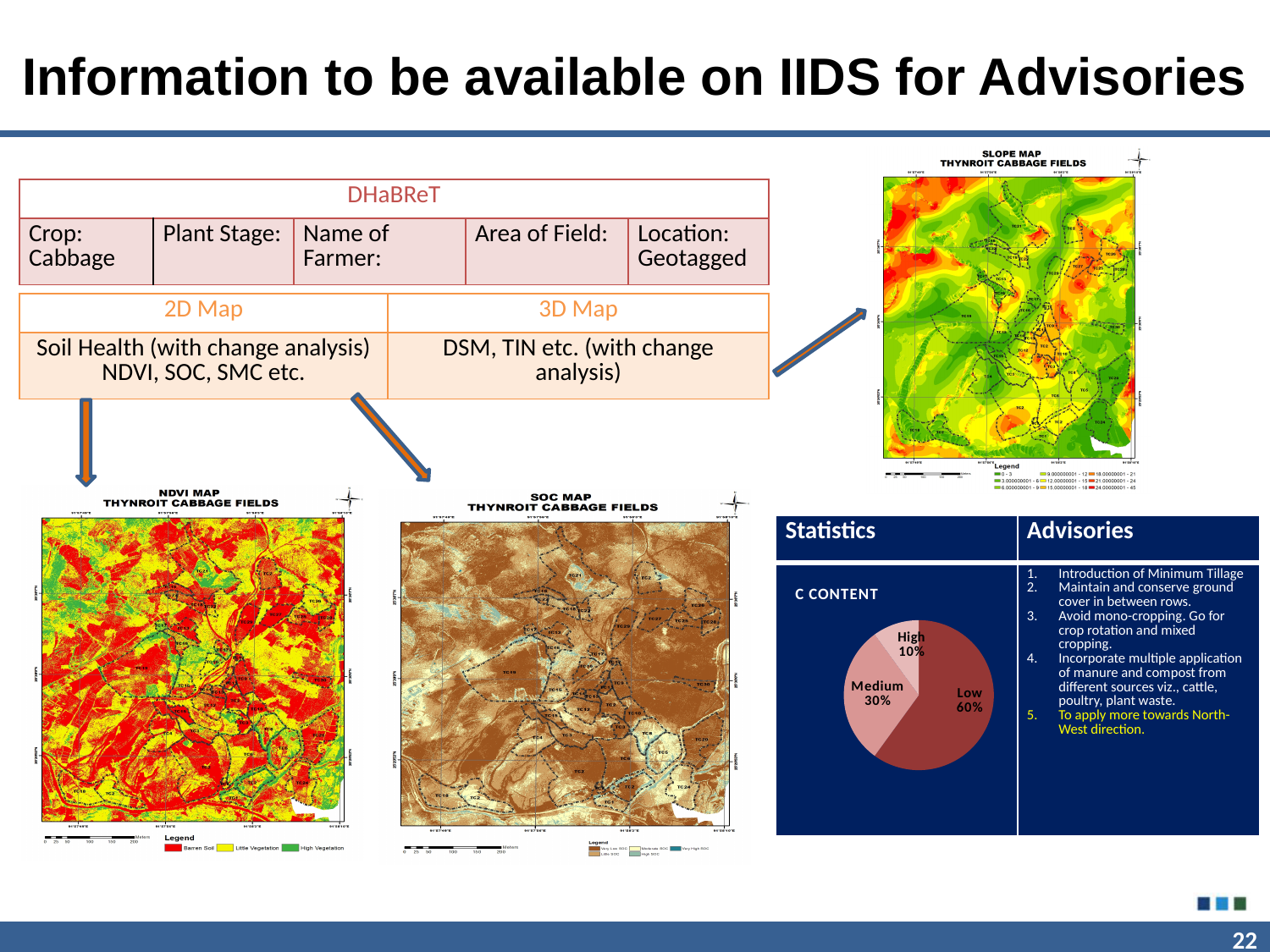
In the C CONTENT pie chart, what share does the Medium slice have? 30% What is the title of the pie chart under the Statistics heading? C CONTENT What kind of chart is shown under the Statistics heading? Pie chart In the C CONTENT pie chart, what is the combined share of the Medium and High slices? 40% In the C CONTENT pie chart, what share does the High slice have? 10% In the C CONTENT pie chart, what share does the Low slice have? 60% In the C CONTENT pie chart, which is larger, the Medium slice or the High slice? Medium In the C CONTENT pie chart, what is the difference between the Medium and High shares? 20% In the C CONTENT pie chart, what is the difference between the Low and Medium shares? 30% In the C CONTENT pie chart, which category has the smallest share? High In the C CONTENT pie chart, which category has the largest share? Low How many slices does the C CONTENT pie chart have? 3